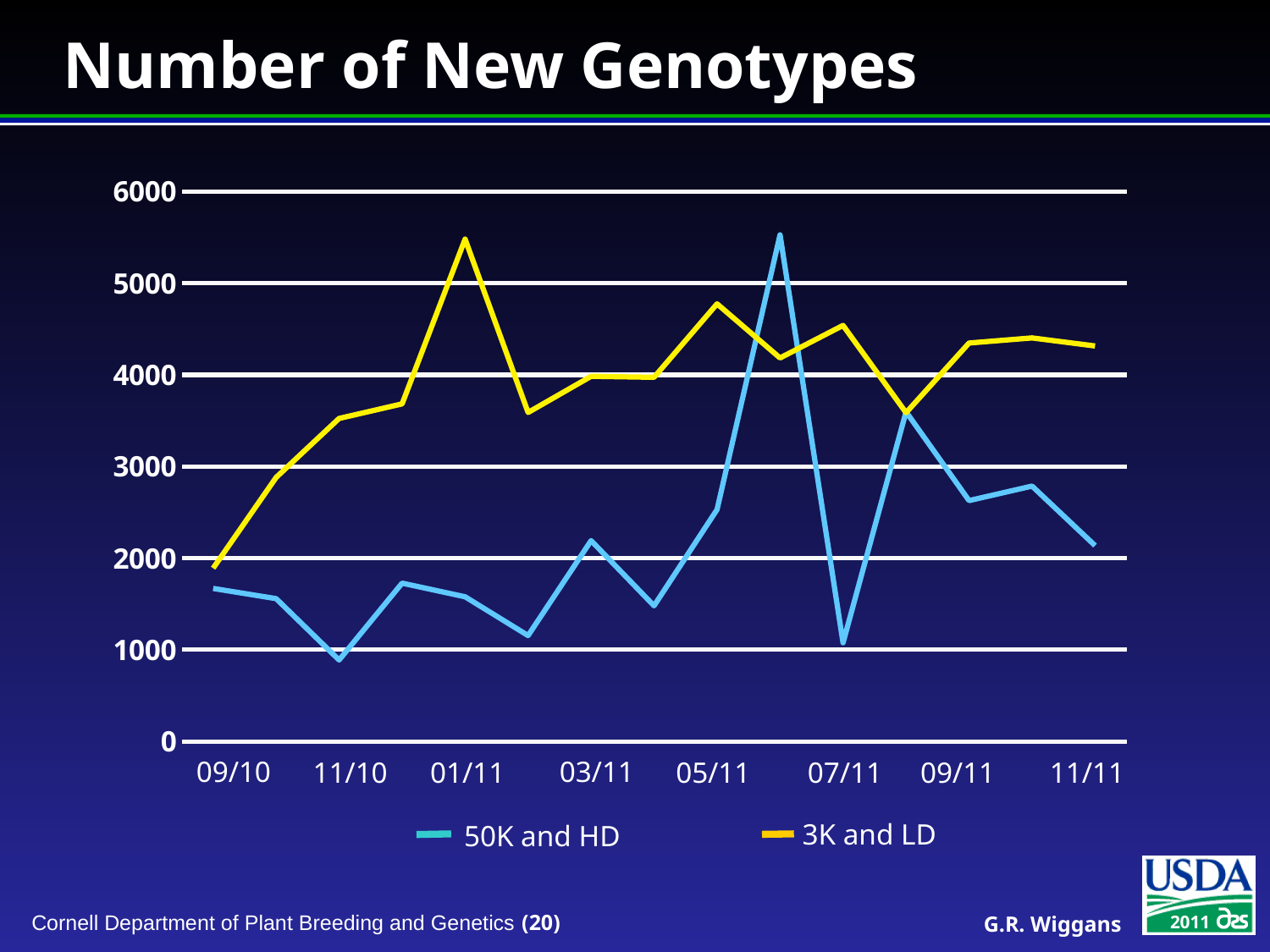
At which labelled month does the 3K and LD series reach its highest value? 01/11 Is the value for 3K and LD at 01/11 greater or less than 5000? greater Is the value for 3K and LD at 11/11 greater or less than 4000? greater At which labelled month is the 3K and LD series at its lowest value? 09/10 How many series does the legend list? 2 At 07/11, which series has the higher value, 50K and HD or 3K and LD? 3K and LD Is the value for 50K and HD at 09/11 greater or less than 3000? less What is the title of the chart? Number of New Genotypes What colour is the line for the 3K and LD series? yellow What kind of chart is shown on the slide? line chart